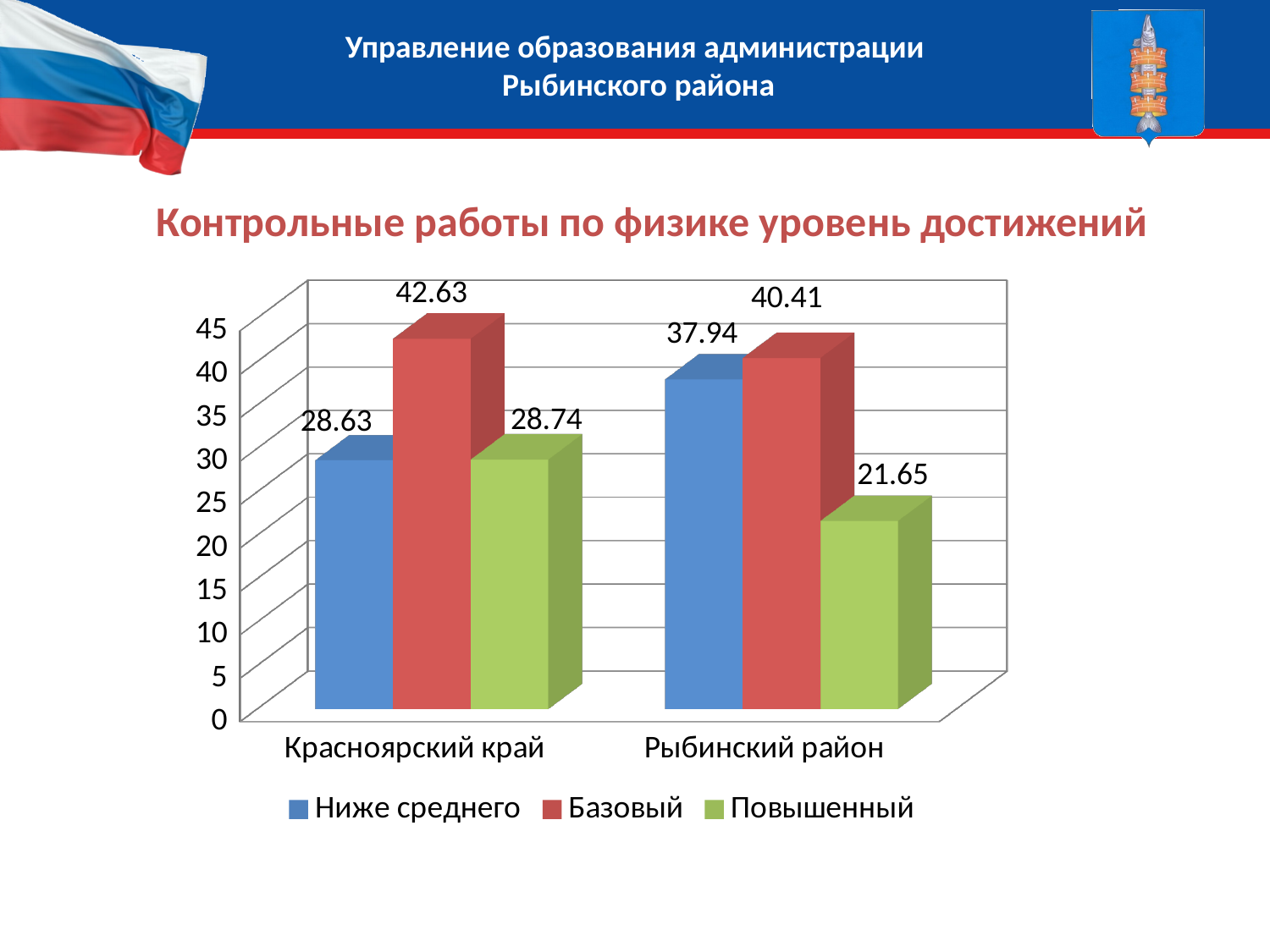
What is the value for Базовый in Красноярский край? 42.63 Is the value for Повышенный in Красноярский край greater or less than 25? greater How many categories are shown on the x axis? 2 Which is larger: Ниже среднего in Красноярский край or Ниже среднего in Рыбинский район? Рыбинский район What kind of chart is shown on the slide? bar chart What is the value for Ниже среднего in Рыбинский район? 37.94 What is the value for Повышенный in Рыбинский район? 21.65 What is the title of the chart? Контрольные работы по физике уровень достижений Which series has the highest value in Красноярский край? Базовый How many series does the legend list? 3 What is the difference between the Базовый values for Красноярский край and Рыбинский район? 2.22 Which series has the lowest value in Рыбинский район? Повышенный